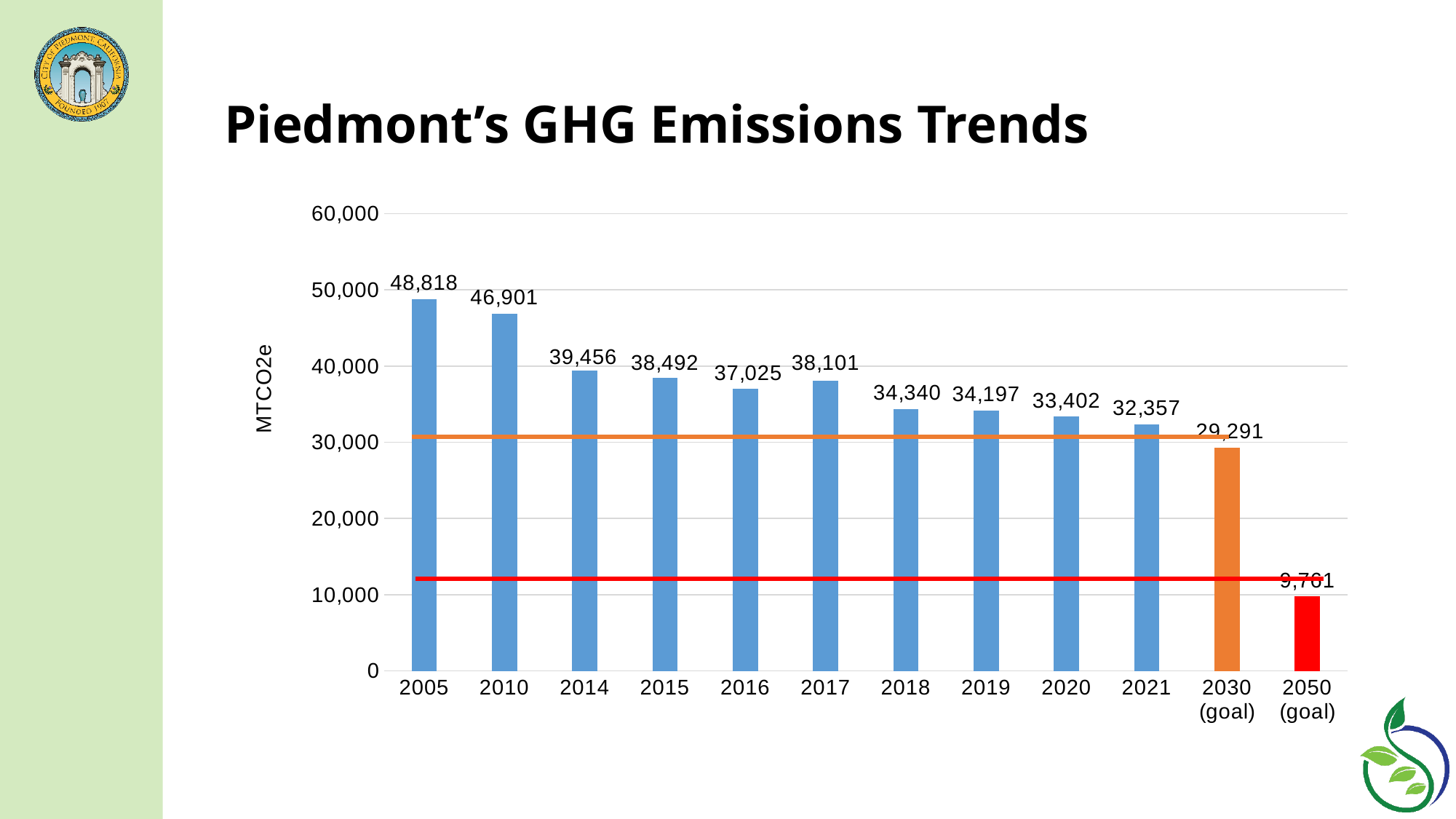
What is the difference between the values for 2020 and 2021? 1,045 How many bars are shown in the chart? 12 What kind of chart is shown on the slide? bar chart What is the difference between the values for 2005 and 2010? 1,917 Which category has the lowest value? 2050 (goal) What is the value for 2017? 38,101 Which is larger, the value for 2016 or the value for 2017? 2017 Is the value for 2050 (goal) greater or less than 10,000? less What is the label on the vertical axis? MTCO2e What is the value for 2005? 48,818 Which year has the highest emissions value? 2005 What is the value for 2021? 32,357